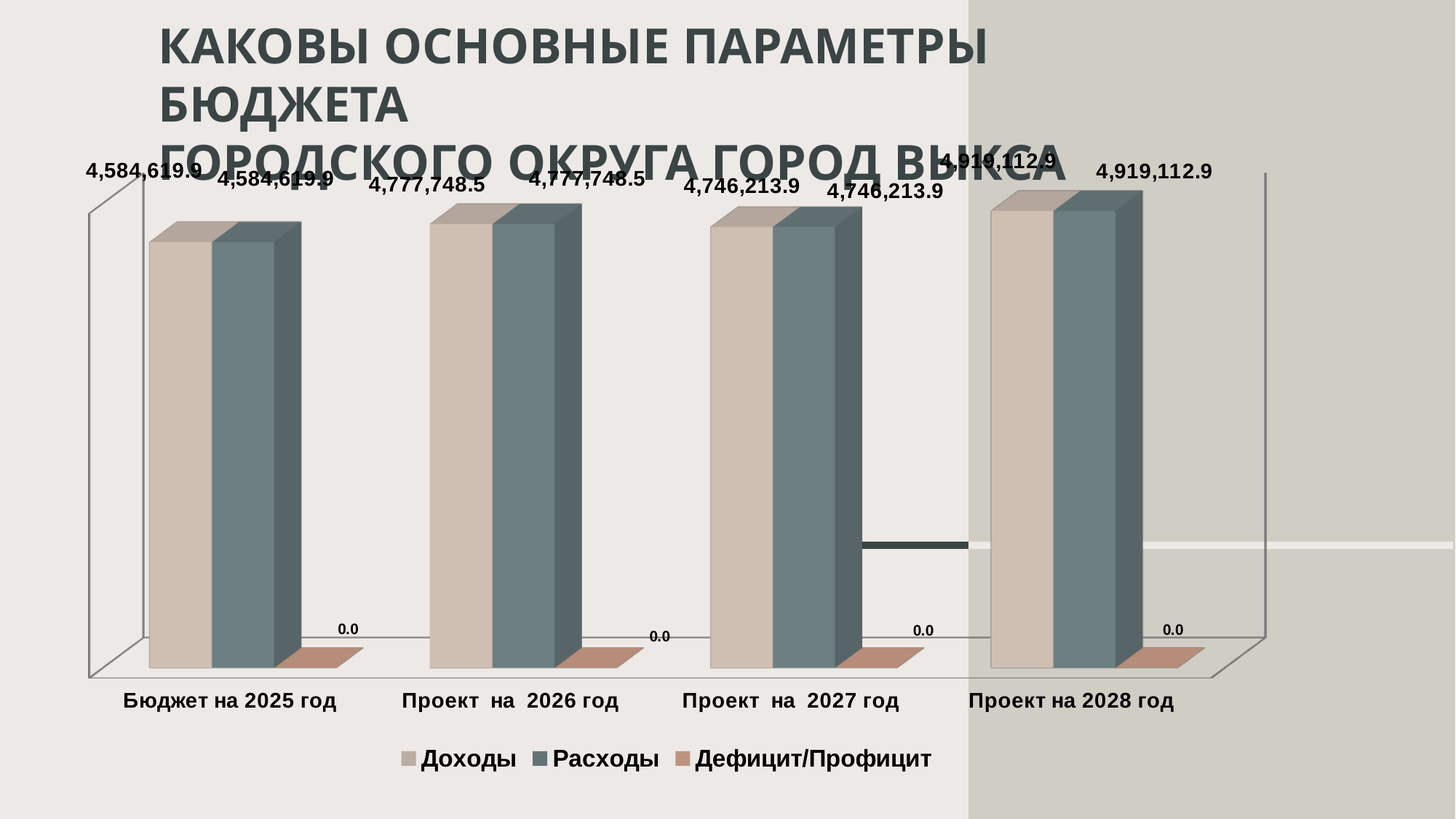
What is the value of Доходы for Проект на 2027 год? 4,746,213.9 Which is larger: Расходы for Проект на 2026 год or Расходы for Проект на 2027 год? Проект на 2026 год What is the value of Дефицит/Профицит for Проект на 2026 год? 0.0 Which category has the highest value for Доходы? Проект на 2028 год Which category has the lowest value for Расходы? Бюджет на 2025 год How many categories are shown on the x axis? 4 How many series does the legend list? 3 What is the value of Расходы for Проект на 2028 год? 4,919,112.9 What kind of chart is shown on the slide? Bar chart What is the value of Доходы for Бюджет на 2025 год? 4,584,619.9 What is the value of Расходы for Проект на 2026 год? 4,777,748.5 What is the difference between Доходы for Проект на 2028 год and Доходы for Бюджет на 2025 год? 334,493.0